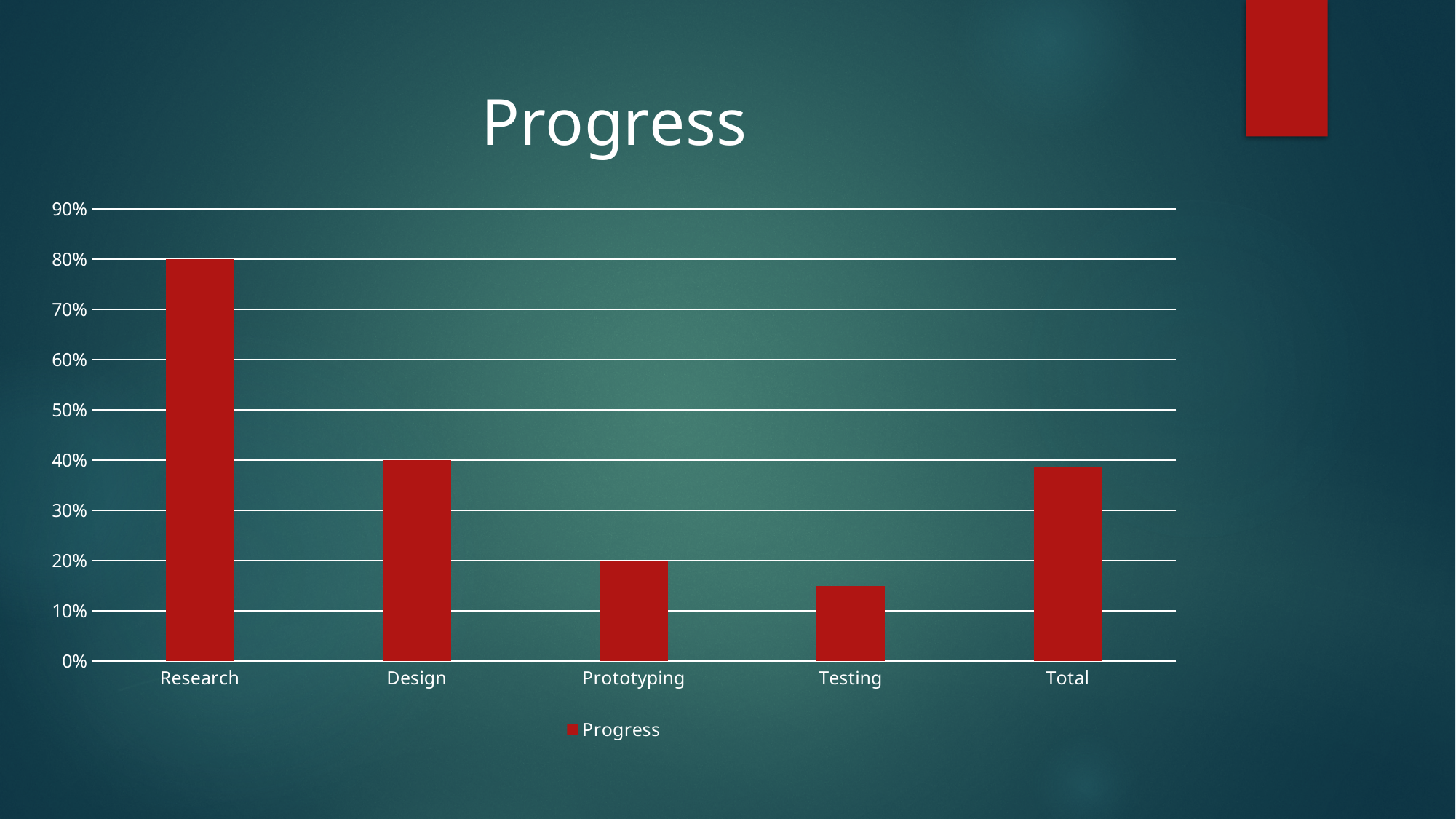
What is the value for Design? 40% Which is larger, the value for Research or the value for Total? Research What is the value for Prototyping? 20% Which category has the lowest value? Testing How many series does the legend list? 1 Is the value for Testing greater or less than 10%? greater How many categories are shown on the x axis? 5 Which category has the highest value? Research Is the value for Total greater or less than 30%? greater What is the value for Research? 80% What is the difference between the values for Research and Design? 40% What kind of chart is shown on the slide? bar chart